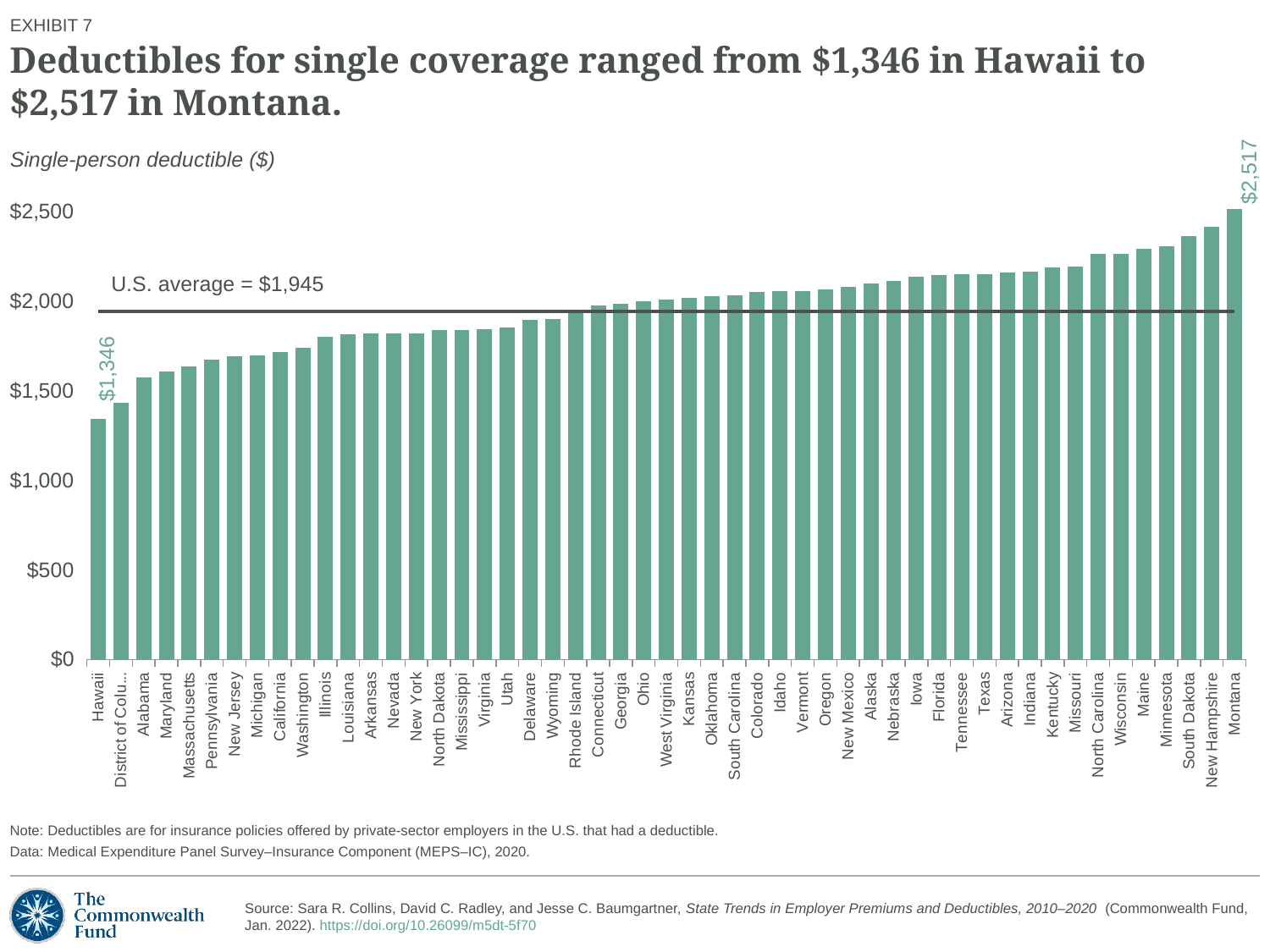
Which state has the lowest single-person deductible? Hawaii What is the single-person deductible for Montana? $2,517 What is the single-person deductible for Hawaii? $1,346 Is the value for Texas greater or less than $2,000? greater Which state has the highest single-person deductible? Montana What U.S. average value is marked by the horizontal line on the chart? $1,945 How many bars are plotted on the chart? 51 What is the difference between the deductibles for Montana and Hawaii? $1,171 Is the value for Illinois greater or less than $2,000? less What kind of chart is shown on the slide? Bar chart Which has a larger single-person deductible, Maine or Alabama? Maine Is the value for Alabama greater or less than $1,500? greater